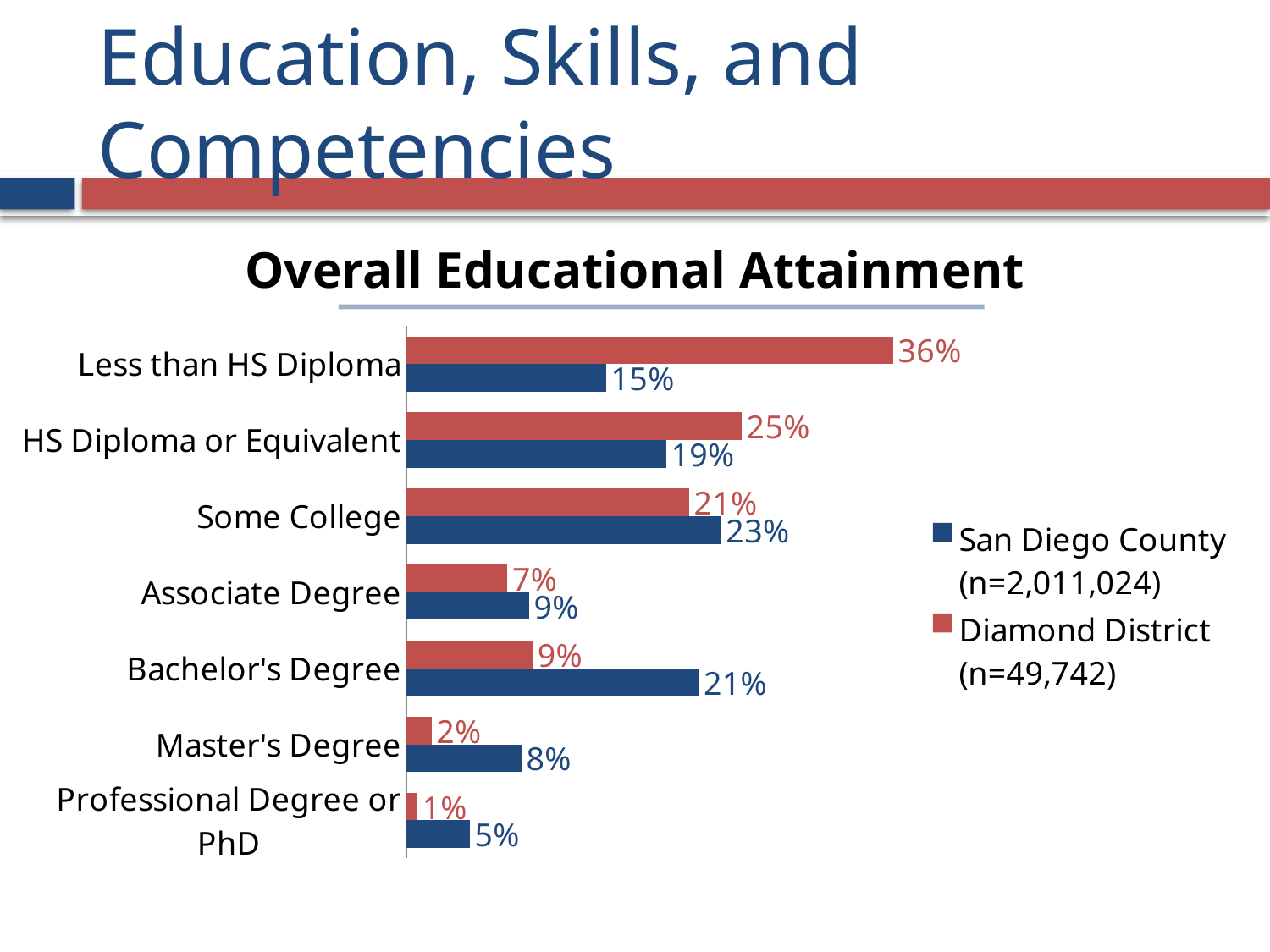
What is the difference between the San Diego County and Diamond District values for Bachelor's Degree? 12% What is the San Diego County value for Bachelor's Degree? 21% For Some College, which series has the larger value, San Diego County or Diamond District? San Diego County How many series does the legend list? 2 What is the difference between the Diamond District and San Diego County values for Less than HS Diploma? 21% What is the Diamond District value for Less than HS Diploma? 36% What kind of chart is shown on the slide? Bar chart What is the San Diego County value for Professional Degree or PhD? 5% Which category has the highest Diamond District value? Less than HS Diploma Which category has the lowest San Diego County value? Professional Degree or PhD What is the title of the chart? Overall Educational Attainment How many education categories are shown in the chart? 7